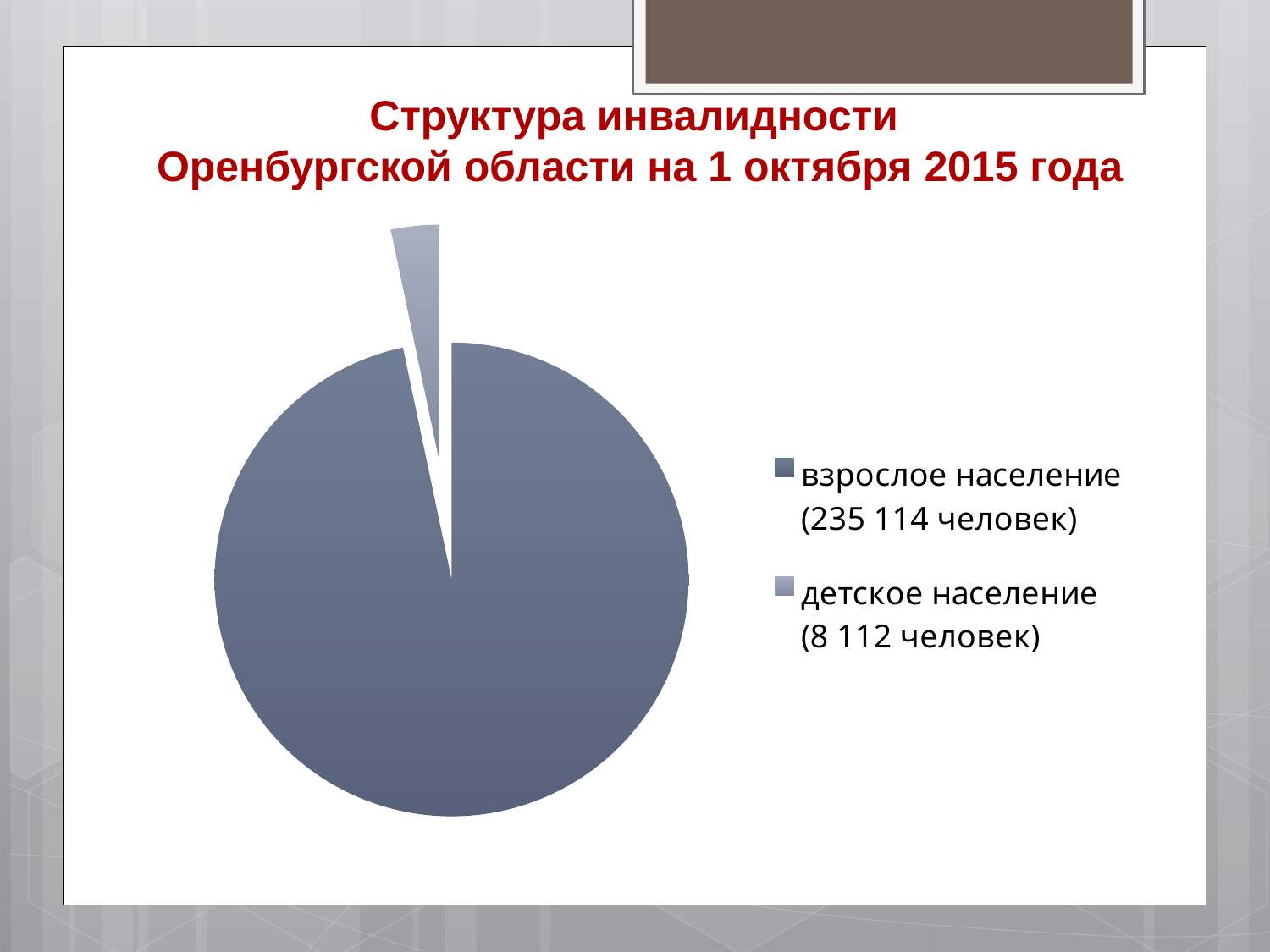
How many people are in the child population (детское население) category according to the legend? 8 112 человек What is the difference between the adult population and the child population values? 227 002 Which is larger: the adult population or the child population? взрослое население Which category has the largest slice of the pie? взрослое население How many slices does the pie chart have? 2 What is the title of the chart on the slide? Структура инвалидности Оренбургской области на 1 октября 2015 года How many people are in the adult population (взрослое население) category according to the legend? 235 114 человек Which category has the smallest slice of the pie? детское население What colour is the slice for the adult population (взрослое население)? Dark blue-grey What kind of chart is shown on the slide? Pie chart What is the total of the two values shown in the legend? 243 226 How many entries does the legend of the pie chart list? 2